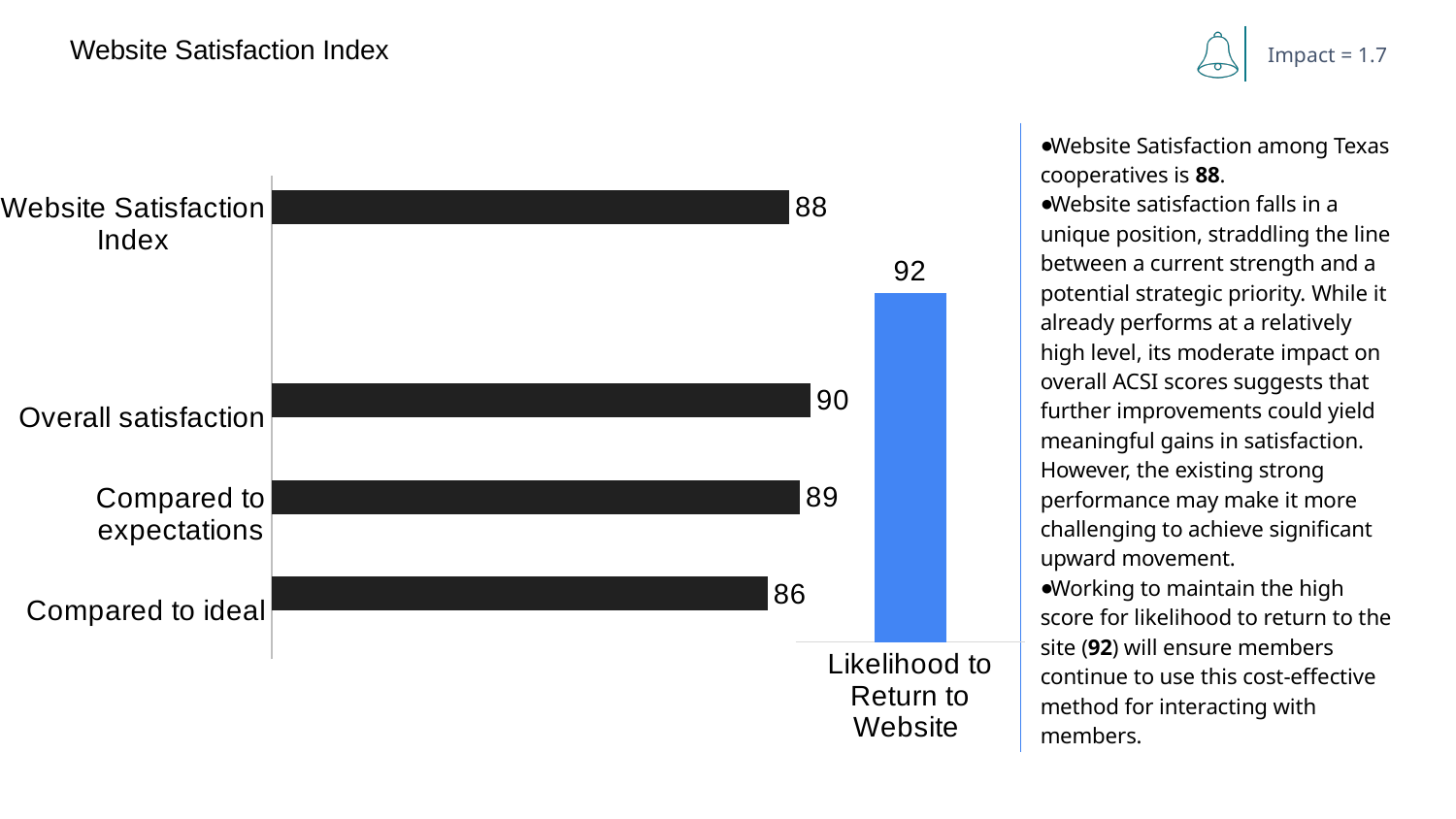
In the horizontal bar chart on the left, what is the value for Website Satisfaction Index? 88 In the horizontal bar chart on the left, which category has the highest value? Overall satisfaction How many categories are shown in the horizontal bar chart on the left? 4 In the horizontal bar chart on the left, what is the value for Overall satisfaction? 90 What type of chart is the chart on the left? Bar chart In the horizontal bar chart on the left, which is larger: Compared to expectations or Website Satisfaction Index? Compared to expectations What colour is the bar for Likelihood to Return to Website in the chart on the right? Blue In the horizontal bar chart on the left, what is the value for Compared to expectations? 89 In the vertical bar chart on the right, what is the value for Likelihood to Return to Website? 92 In the horizontal bar chart on the left, what is the difference between Overall satisfaction and Compared to ideal? 4 In the horizontal bar chart on the left, which category has the lowest value? Compared to ideal In the horizontal bar chart on the left, what is the value for Compared to ideal? 86